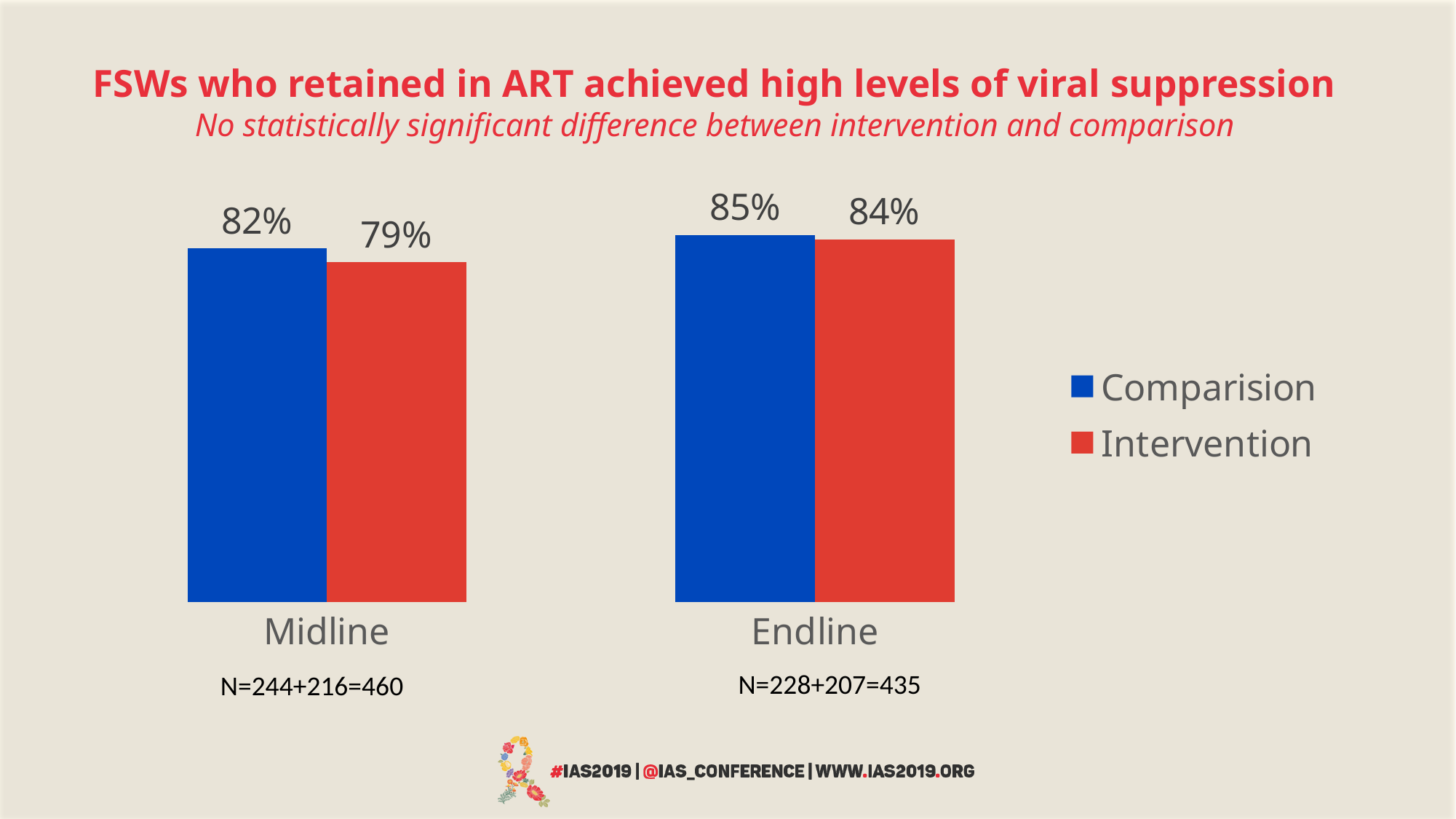
Which bar has the highest value on the chart? Comparision at Endline What is the difference between the Comparision and Intervention values at Midline? 3% What is the difference between the Intervention values at Endline and Midline? 5% What is the Intervention value for Endline? 84% How many categories are shown on the x axis? 2 How many series does the legend list? 2 Which is larger at Midline, the Comparision value or the Intervention value? Comparision What is the Intervention value for Midline? 79% What is the Comparision value for Midline? 82% Which bar has the lowest value on the chart? Intervention at Midline What is the Comparision value for Endline? 85% What kind of chart is shown on the slide? Bar chart